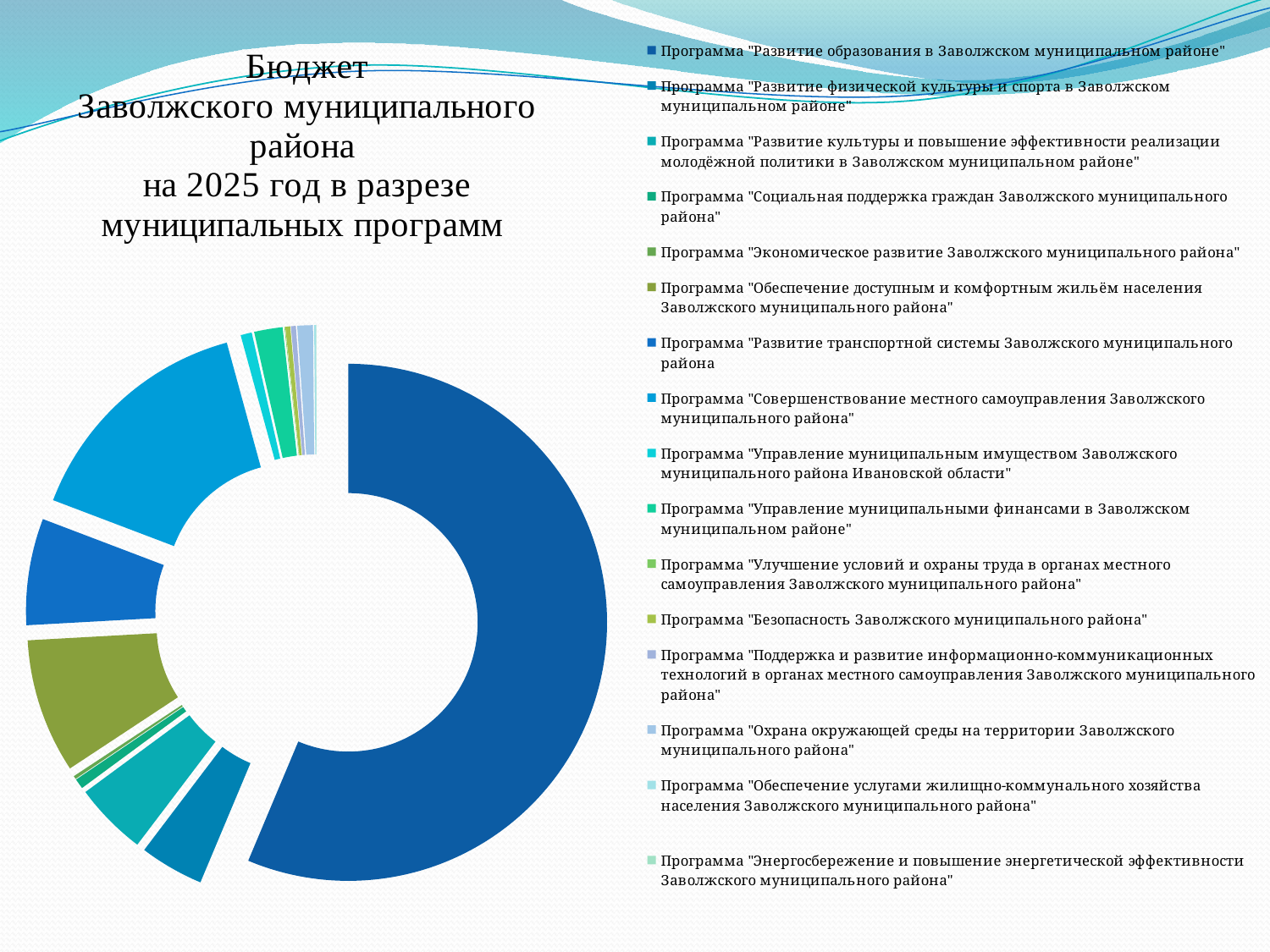
Which program is listed first in the chart legend? Программа "Развитие образования в Заволжском муниципальном районе" What is the title of the slide with the chart? Бюджет Заволжского муниципального района на 2025 год в разрезе муниципальных программ What kind of chart is shown on the slide? Doughnut (pie) chart How many programs are listed in the chart legend? 16 Which is larger: the slice for "Развитие образования в Заволжском муниципальном районе" or the slice for "Энергосбережение и повышение энергетической эффективности Заволжского муниципального района"? Развитие образования в Заволжском муниципальном районе Which year does the budget chart refer to? 2025 Which program has the largest slice in the chart? Программа "Развитие образования в Заволжском муниципальном районе"